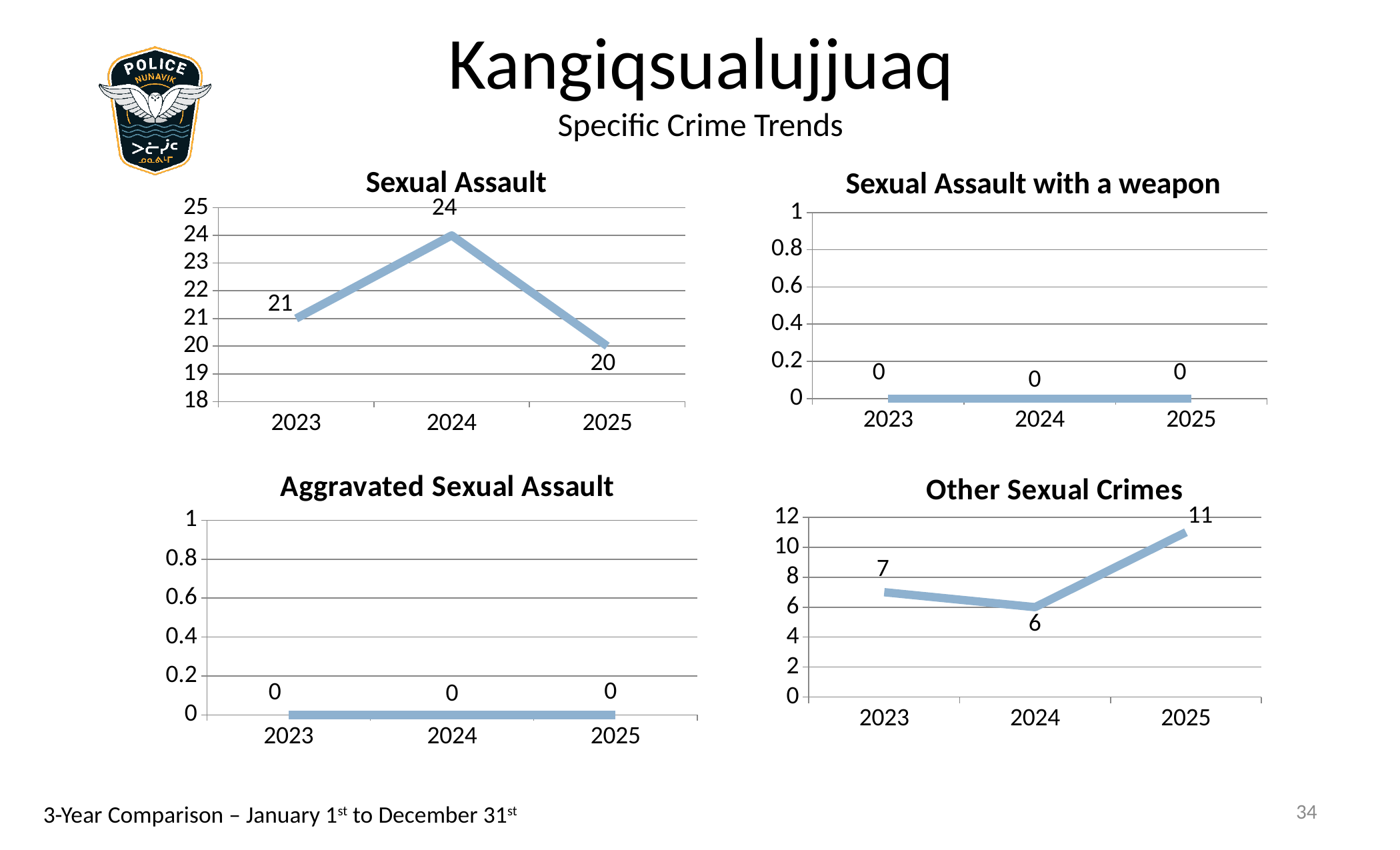
In the Sexual Assault chart, what is the value for 2024? 24 In the Other Sexual Crimes chart, what is the value for 2025? 11 In the Sexual Assault chart, which year has the lowest value? 2025 In the Sexual Assault chart, do the values rise or fall from 2024 to 2025? fall In the Other Sexual Crimes chart, which is larger, the value for 2023 or the value for 2024? 2023 What kind of chart is the Other Sexual Crimes chart? line chart In the Other Sexual Crimes chart, which year has the highest value? 2025 In the Other Sexual Crimes chart, what is the difference between the 2025 and 2024 values? 5 In the Aggravated Sexual Assault chart, how many years are plotted? 3 In the Sexual Assault chart, what is the difference between the 2024 and 2023 values? 3 In the Sexual Assault with a weapon chart, what is the value for 2024? 0 In the Sexual Assault chart, is the value for 2023 greater or less than 20? greater